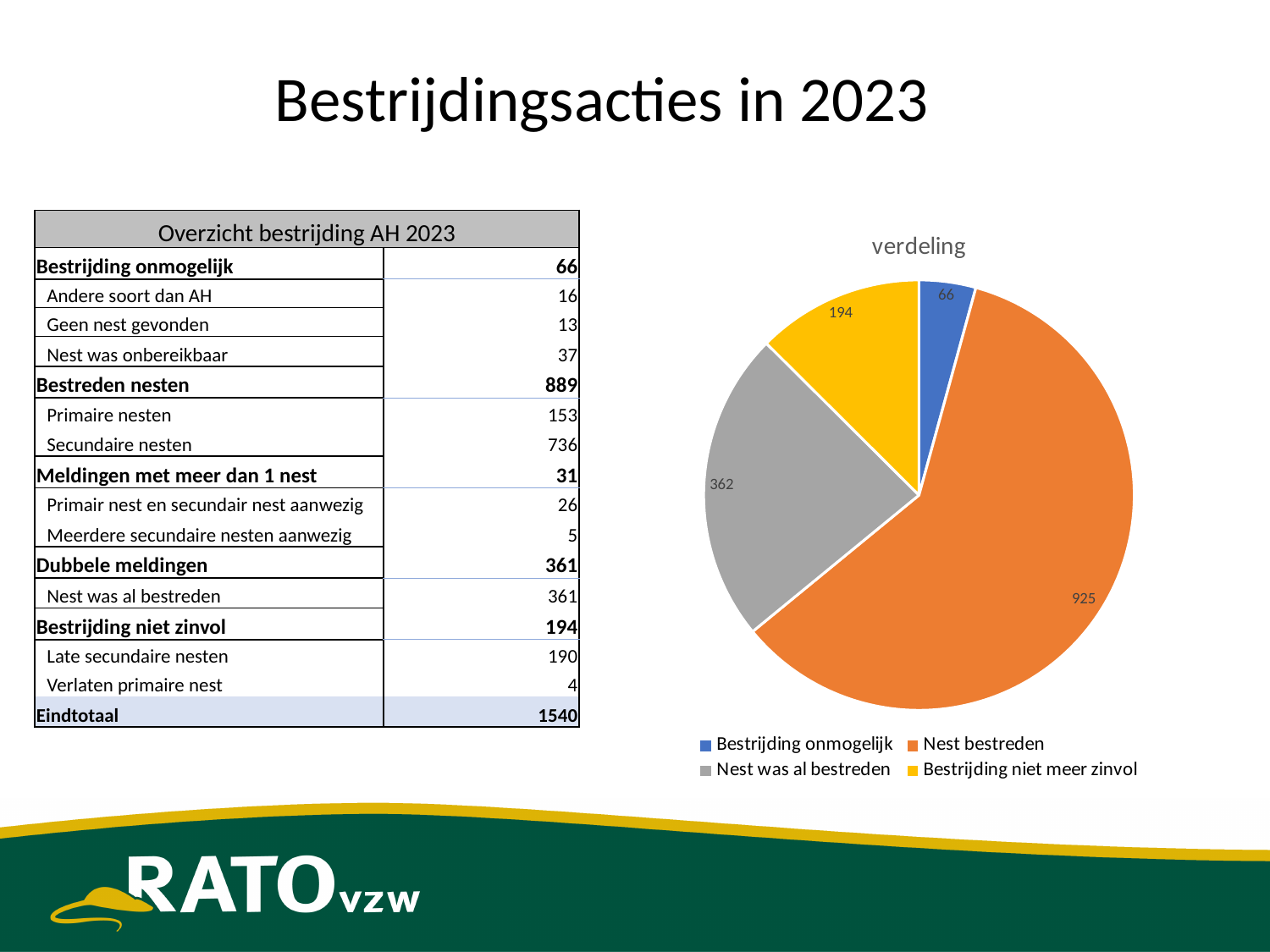
Which colour represents Bestrijding niet meer zinvol in the pie chart? yellow What type of chart is shown on the slide? pie chart What is the title of the pie chart? verdeling Which is larger in the pie chart: Nest was al bestreden or Bestrijding niet meer zinvol? Nest was al bestreden What is the value for Nest was al bestreden in the pie chart? 362 What is the value for Bestrijding niet meer zinvol in the pie chart? 194 Which category has the largest slice in the pie chart? Nest bestreden How many categories does the pie chart show? 4 What is the value for Bestrijding onmogelijk in the pie chart? 66 Which category has the smallest slice in the pie chart? Bestrijding onmogelijk What is the difference between the values for Nest bestreden and Nest was al bestreden? 563 What is the value for Nest bestreden in the pie chart? 925